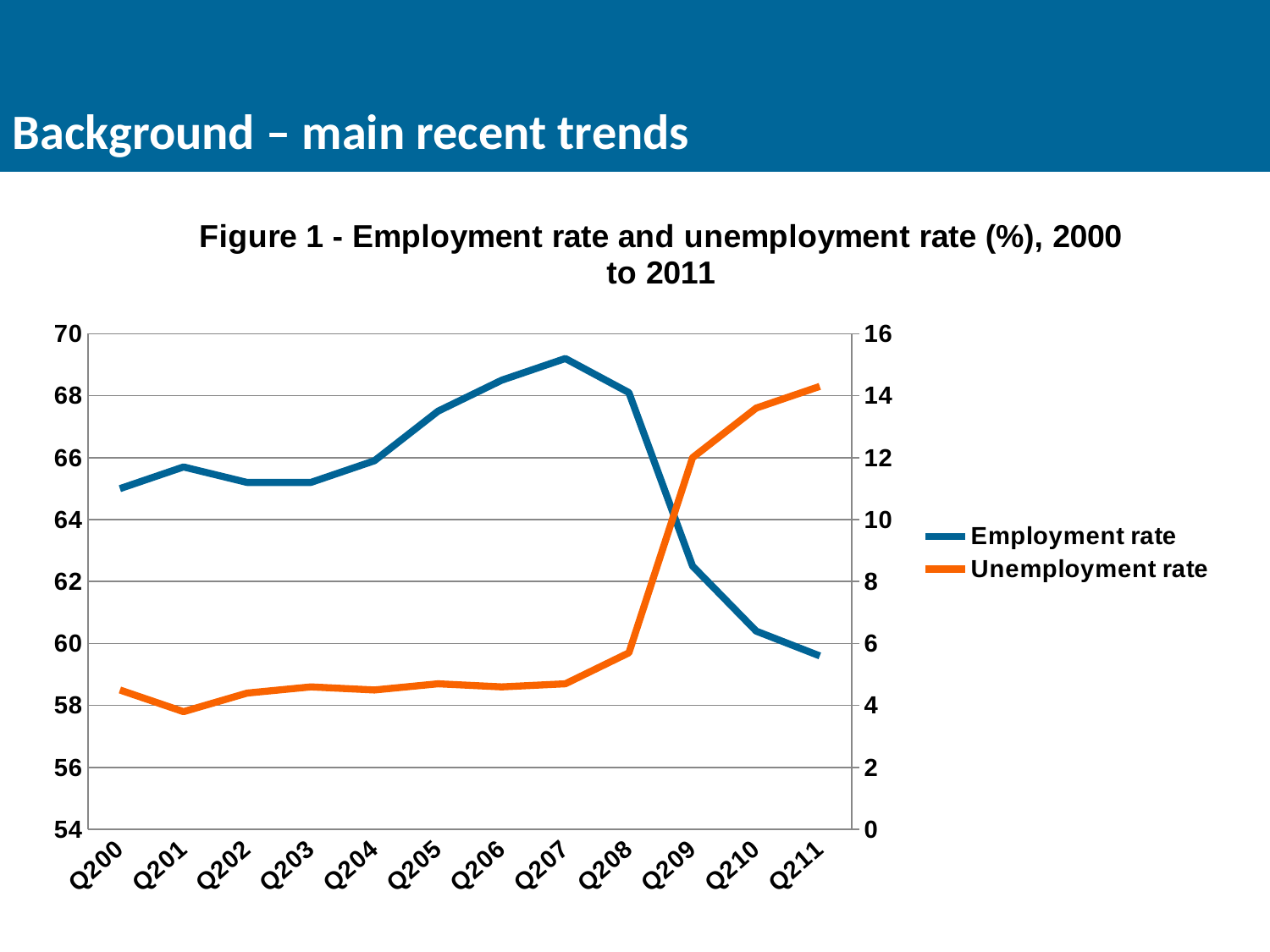
Does the employment rate rise or fall from Q207 to Q211? fall In which quarter is the unemployment rate highest? Q211 What kind of chart is shown in Figure 1? line chart In which quarter is the employment rate lowest? Q211 How many quarters are plotted along the x axis of Figure 1? 12 Is the unemployment rate at Q209 greater or less than 10? greater How many series does the legend list in Figure 1? 2 Is the employment rate at Q207 greater or less than 68? greater In which quarter is the employment rate highest? Q207 Is the employment rate at Q209 greater or less than 64? less In which quarter is the unemployment rate lowest? Q201 Which series is drawn in orange in Figure 1? Unemployment rate